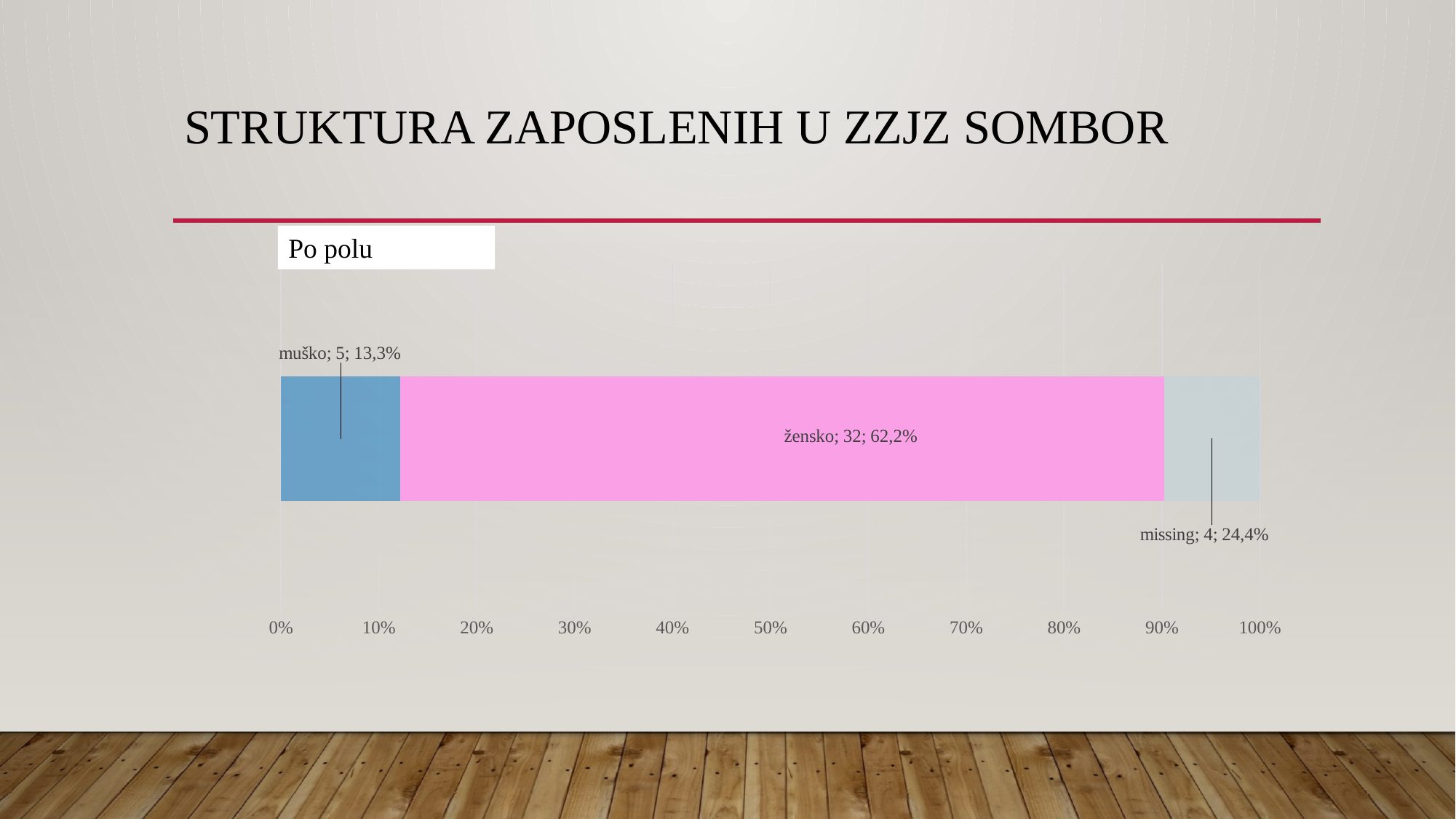
Which has a larger count in the Po polu chart, muško or missing? muško What is the count shown for the muško segment in the Po polu chart? 5 What kind of chart is shown on the slide? Stacked bar chart How many segments make up the bar in the Po polu chart? 3 What is the count shown for the žensko segment in the Po polu chart? 32 What is the count shown for the missing segment in the Po polu chart? 4 Which segment of the Po polu chart has the lowest count? missing What percentage is printed for the žensko segment in the Po polu chart? 62,2% What percentage is printed for the muško segment in the Po polu chart? 13,3% Which segment of the Po polu chart has the highest count? žensko What is the difference between the žensko count and the muško count in the Po polu chart? 27 What is the total count across all segments of the bar in the Po polu chart? 41